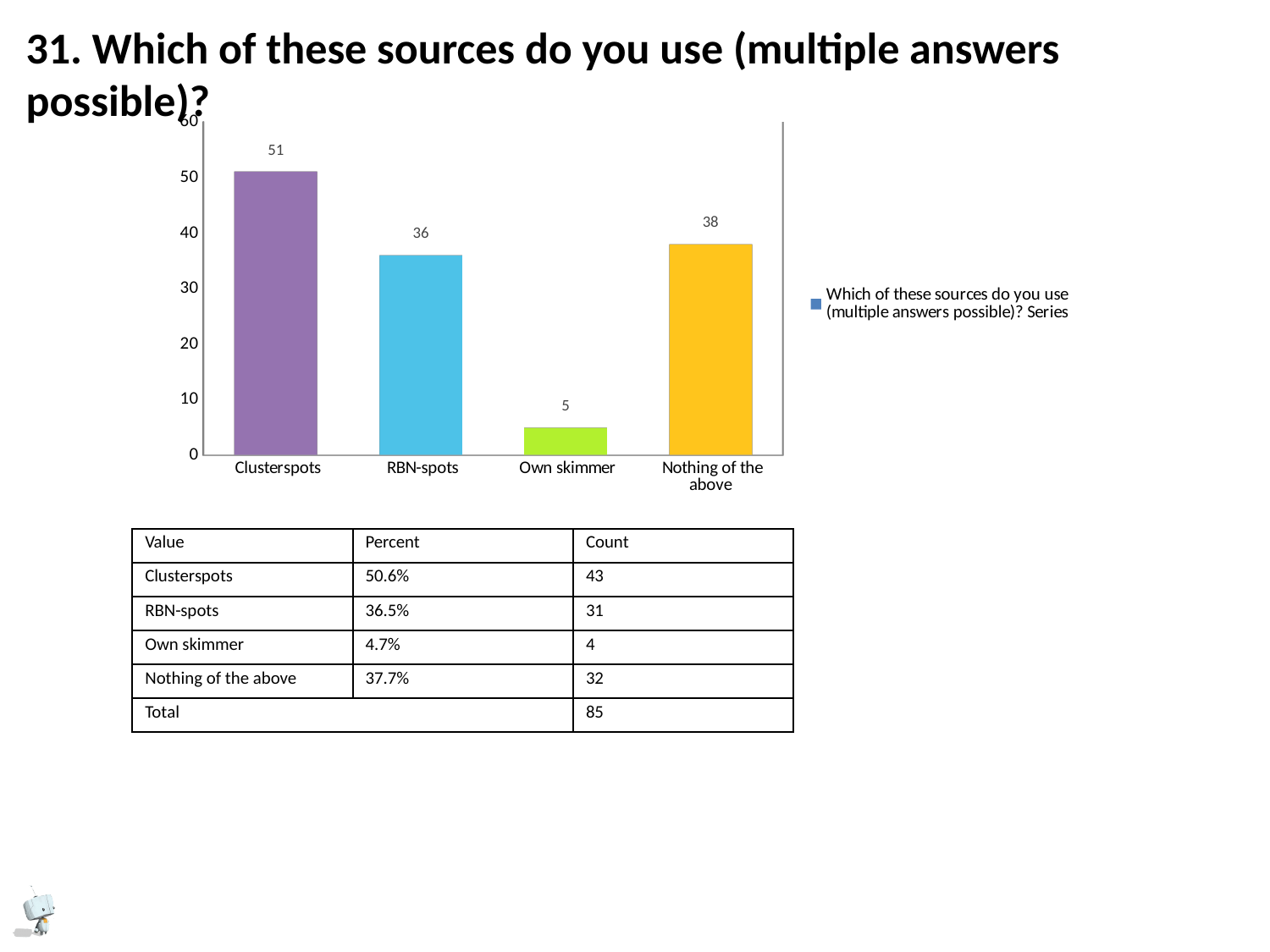
What kind of chart is shown on the slide? bar chart What value does the chart show for Own skimmer? 5 In the chart, what is the difference between the values for Clusterspots and Nothing of the above? 13 In the chart, which is larger: the value for RBN-spots or the value for Nothing of the above? Nothing of the above Which category has the highest bar in the chart? Clusterspots What colour is the bar for Own skimmer? green Is the bar for RBN-spots greater or less than 40? less What value does the chart show for RBN-spots? 36 How many categories are shown on the x axis of the chart? 4 What value does the chart show for Nothing of the above? 38 Which category has the lowest bar in the chart? Own skimmer What value does the chart show for Clusterspots? 51